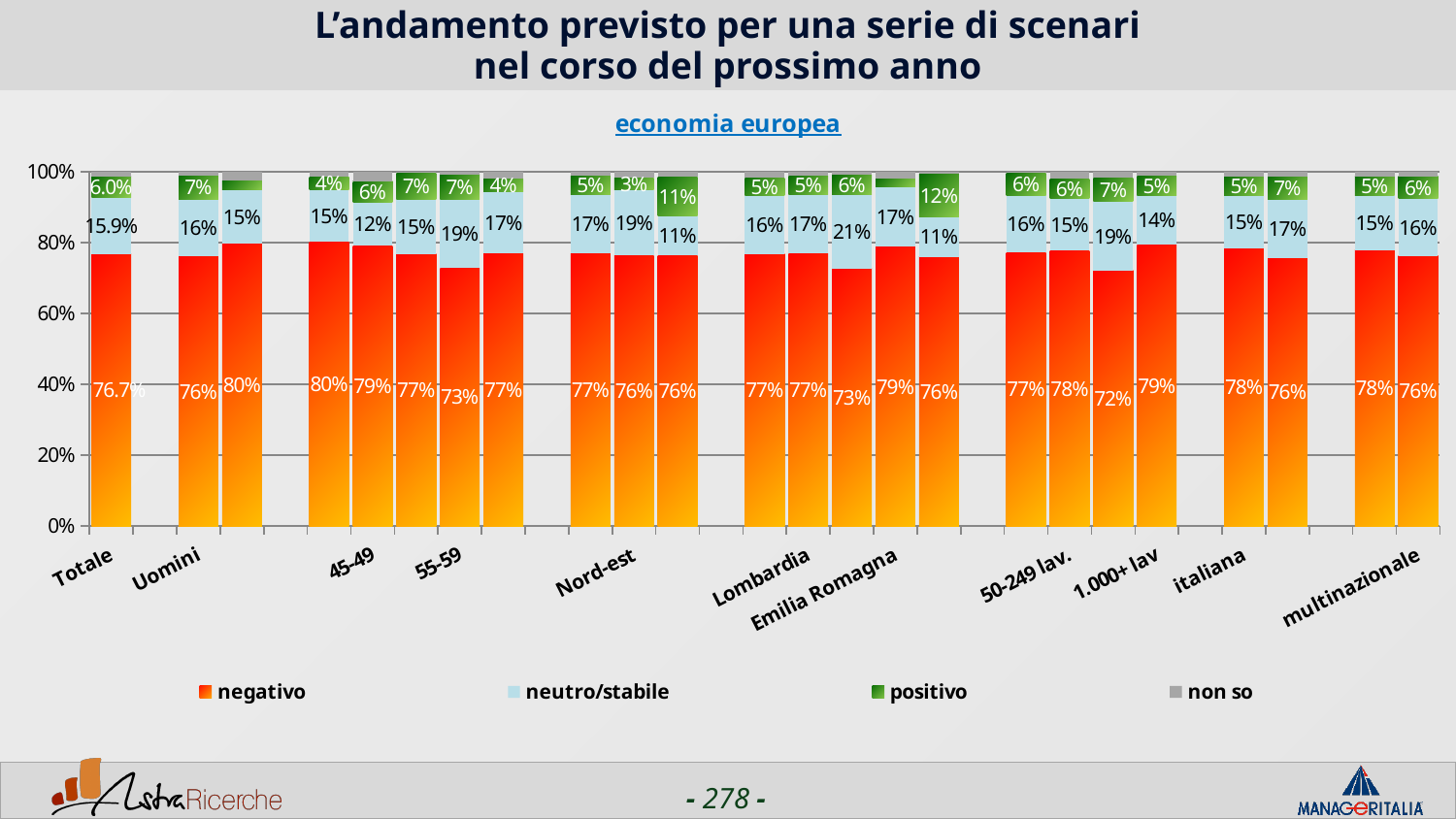
Is the 'negativo' value for Uomini greater or less than 60%? greater How many series does the legend list? 4 What is the 'neutro/stabile' value for Totale? 15.9% What is the 'neutro/stabile' value for Uomini? 16% What is the 'positivo' value for Uomini? 7% What scenario is the chart about, according to the subtitle above it? economia europea What kind of chart is shown on the slide? Stacked bar chart What is the 'positivo' value for Totale? 6.0% Which is larger for Totale, the 'negativo' value or the 'neutro/stabile' value? negativo What is the 'negativo' value for Totale? 76.7% What is the difference between the 'negativo' and 'neutro/stabile' values for Totale? 60.8% What is the 'negativo' value for Uomini? 76%